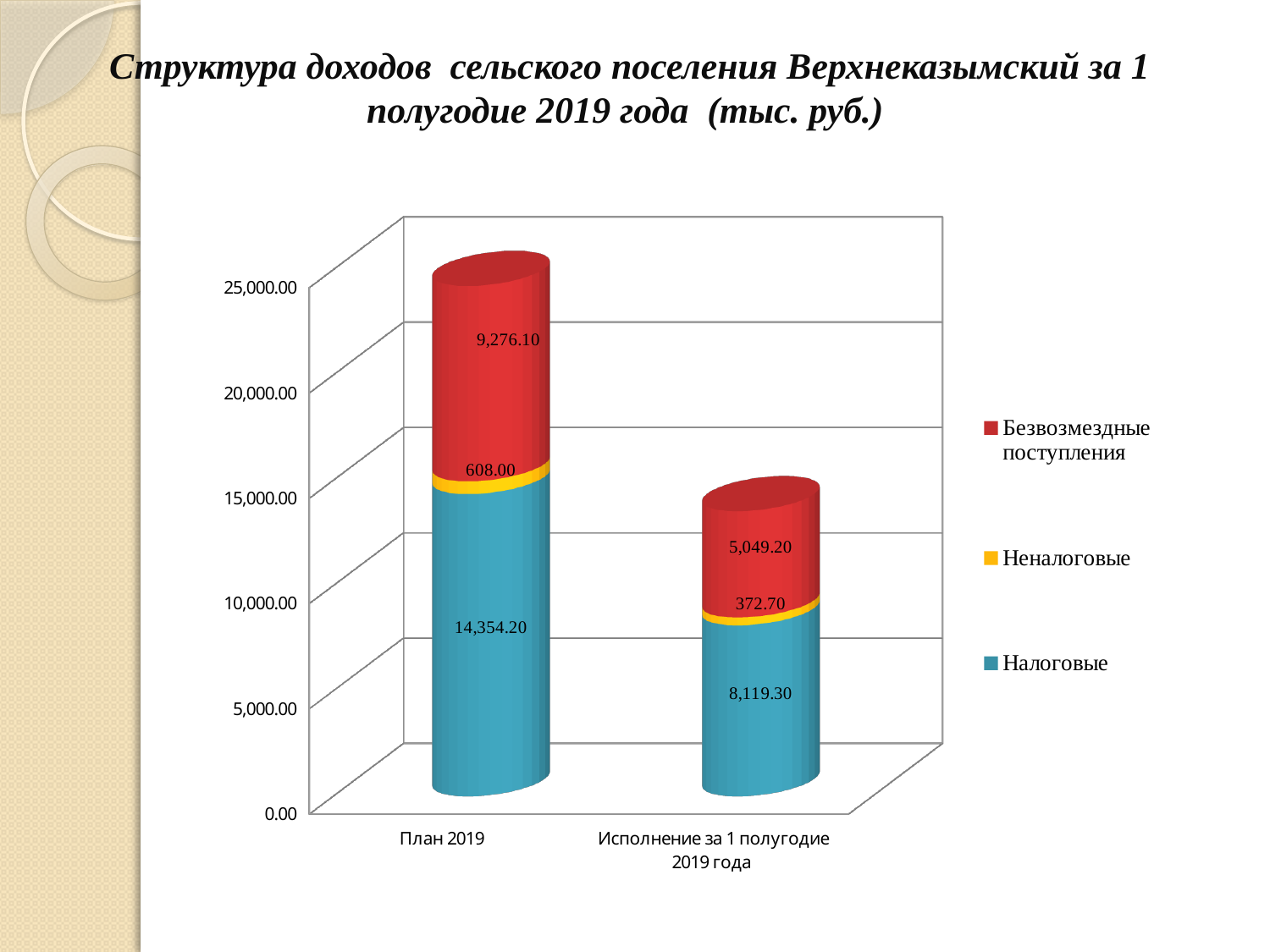
What is the difference between the Безвозмездные поступления values for План 2019 and Исполнение за 1 полугодие 2019 года? 4,226.90 What is the value of Налоговые for План 2019? 14,354.20 What is the total of the stacked bar for План 2019? 24,238.30 What kind of chart is shown on the slide? Stacked bar chart What is the value of Неналоговые for Исполнение за 1 полугодие 2019 года? 372.70 What is the value of Безвозмездные поступления for Исполнение за 1 полугодие 2019 года? 5,049.20 What is the difference between the Налоговые values for План 2019 and Исполнение за 1 полугодие 2019 года? 6,234.90 What is the value of Неналоговые for План 2019? 608.00 How many series does the legend list? 3 How many categories are shown on the x axis? 2 What is the total of the stacked bar for Исполнение за 1 полугодие 2019 года? 13,541.20 Which category has the higher value for Налоговые, План 2019 or Исполнение за 1 полугодие 2019 года? План 2019